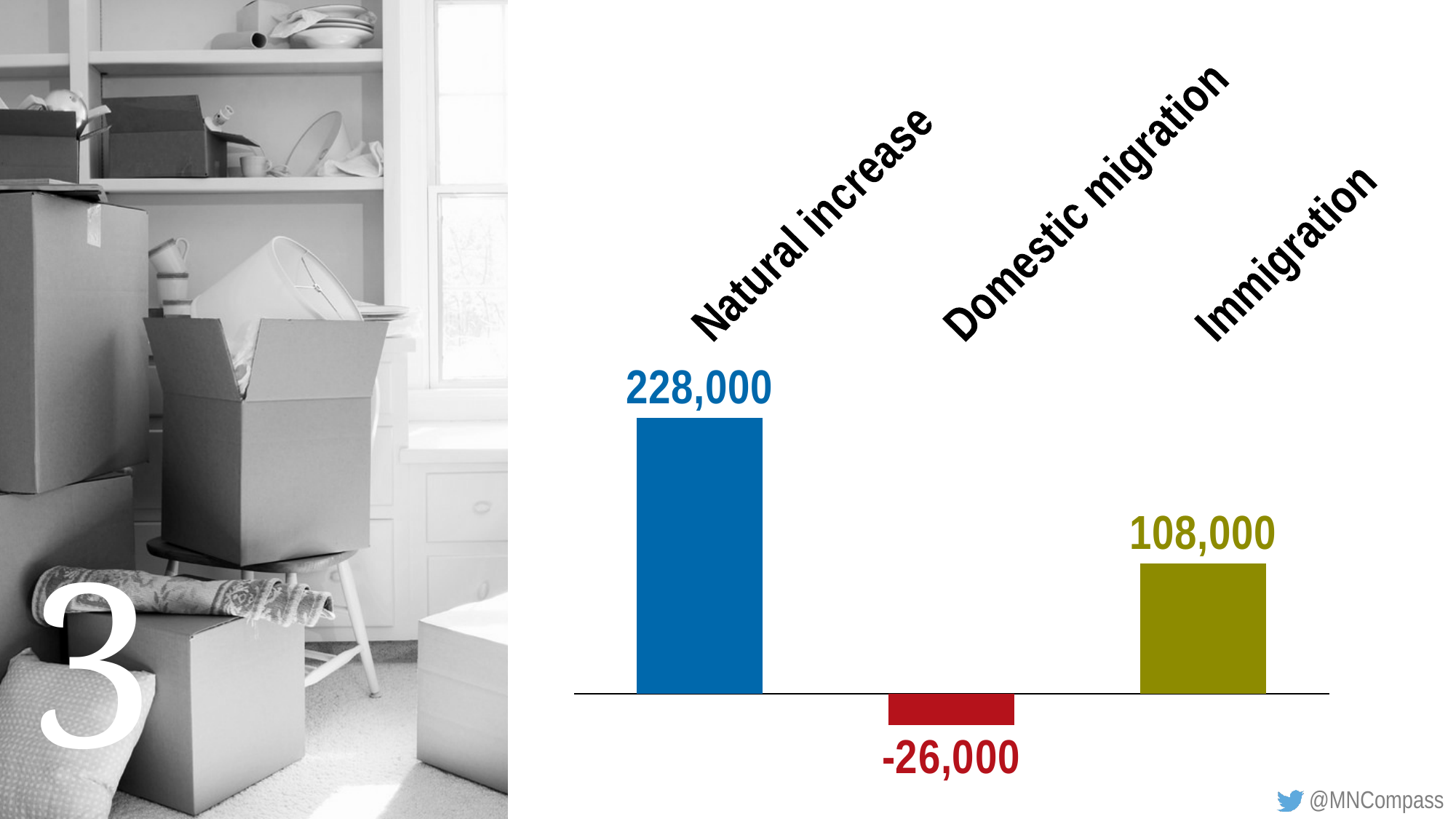
What is the value for Immigration? 108,000 What kind of chart is shown on the slide? Bar chart What is the value for Domestic migration? -26,000 What colour is the bar for Natural increase? Blue What is the value for Natural increase? 228,000 How many categories are shown in the chart? 3 What is the difference between the values for Natural increase and Immigration? 120,000 What is the difference between the values for Immigration and Domestic migration? 134,000 Which category is the only one with a negative value? Domestic migration Which category has the highest value? Natural increase Which is larger, the value for Immigration or the value for Domestic migration? Immigration Which category has the lowest value? Domestic migration